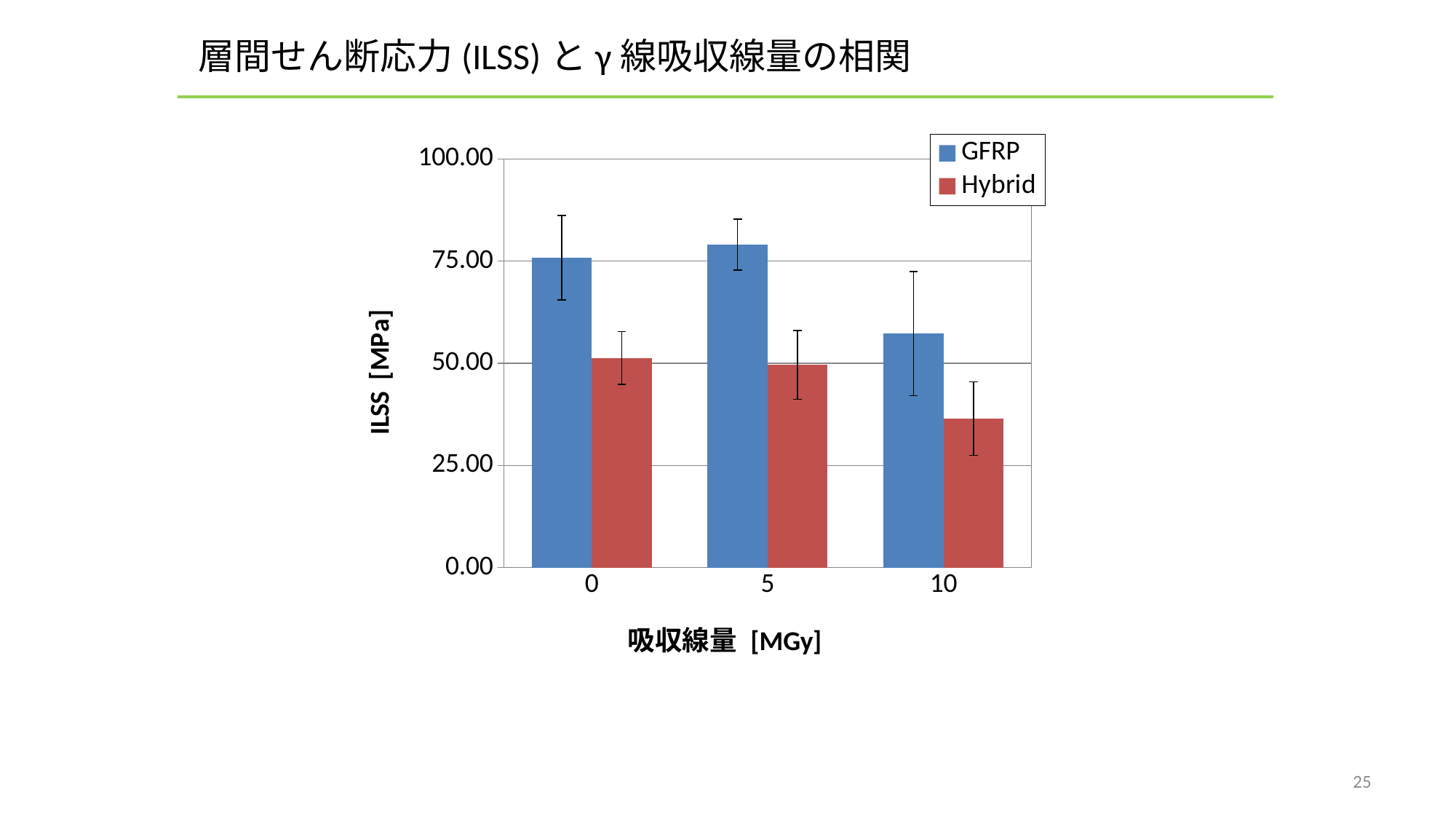
How many series does the legend list? 2 Which series is larger at 0 MGy, GFRP or Hybrid? GFRP How many absorbed dose categories are shown on the x axis? 3 At which absorbed dose is the GFRP value lowest? 10 What kind of chart is shown on the slide? bar chart Which series is larger at 10 MGy, GFRP or Hybrid? GFRP Is the GFRP value at 10 MGy greater or less than 75.00? less Is the GFRP value at 0 MGy greater or less than 50.00? greater Is the Hybrid value at 10 MGy greater or less than 50.00? less Does the Hybrid series rise or fall from 0 MGy to 10 MGy? fall What is the label of the y axis? ILSS [MPa] At which absorbed dose is the Hybrid value lowest? 10